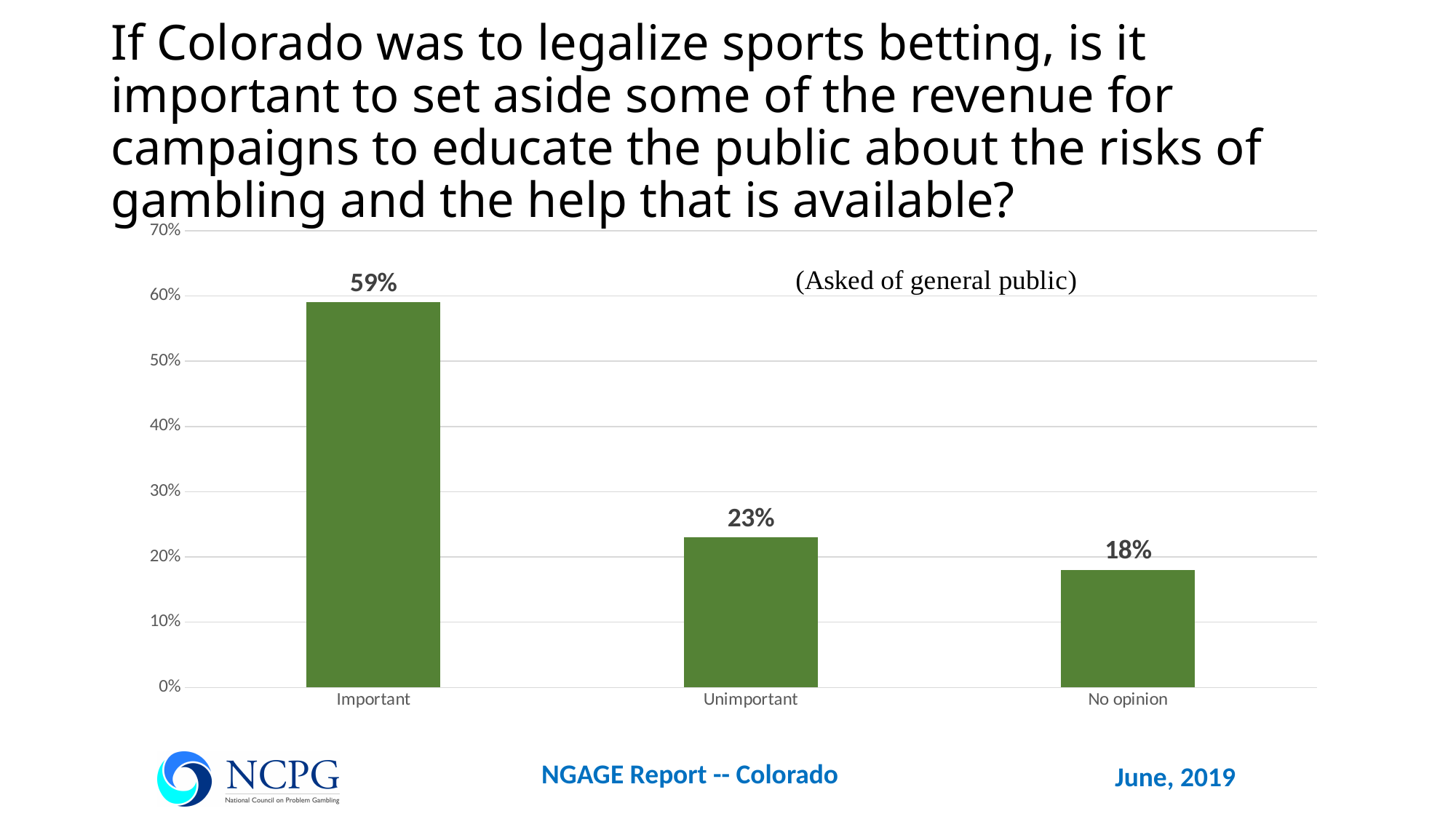
What is the difference between the Important and Unimportant values? 36% What kind of chart is shown on the slide? Bar chart What percentage of respondents said it is important to set aside revenue for education campaigns? 59% What is the value shown for the Unimportant category? 23% What percentage of respondents had no opinion? 18% Which category has the lowest value? No opinion How many categories are shown on the chart? 3 Do the values rise or fall from left to right across the categories? Fall What is the difference between the Unimportant and No opinion values? 5% Is the value for Important greater or less than 50%? greater Which category has the highest value? Important Which is larger, the value for Unimportant or the value for No opinion? Unimportant